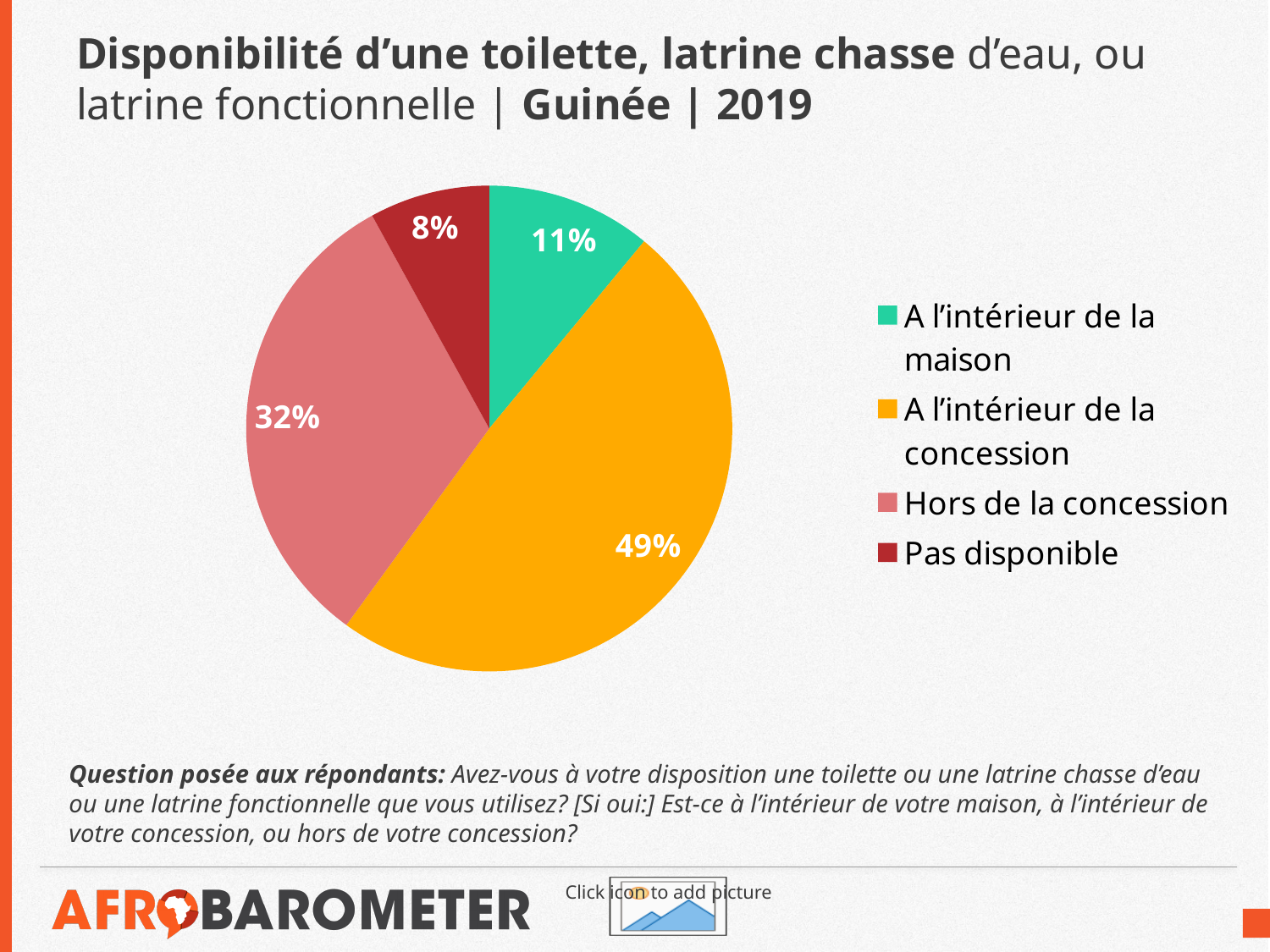
Which category has the largest share of the pie? A l'intérieur de la concession Which category has the smallest share of the pie? Pas disponible What percentage of respondents have a toilet 'A l'intérieur de la maison'? 11% Which colour represents 'Hors de la concession' in the pie chart? Pink What percentage of respondents answered 'Pas disponible'? 8% What percentage of respondents have a toilet 'A l'intérieur de la concession'? 49% What kind of chart is shown on the slide? Pie chart What is the combined share of 'A l'intérieur de la maison' and 'A l'intérieur de la concession'? 60% What is the difference in percentage points between 'A l'intérieur de la concession' and 'Hors de la concession'? 17 What percentage of respondents have a toilet 'Hors de la concession'? 32% How many categories does the pie chart show? 4 Which is larger: 'A l'intérieur de la maison' or 'Pas disponible'? A l'intérieur de la maison